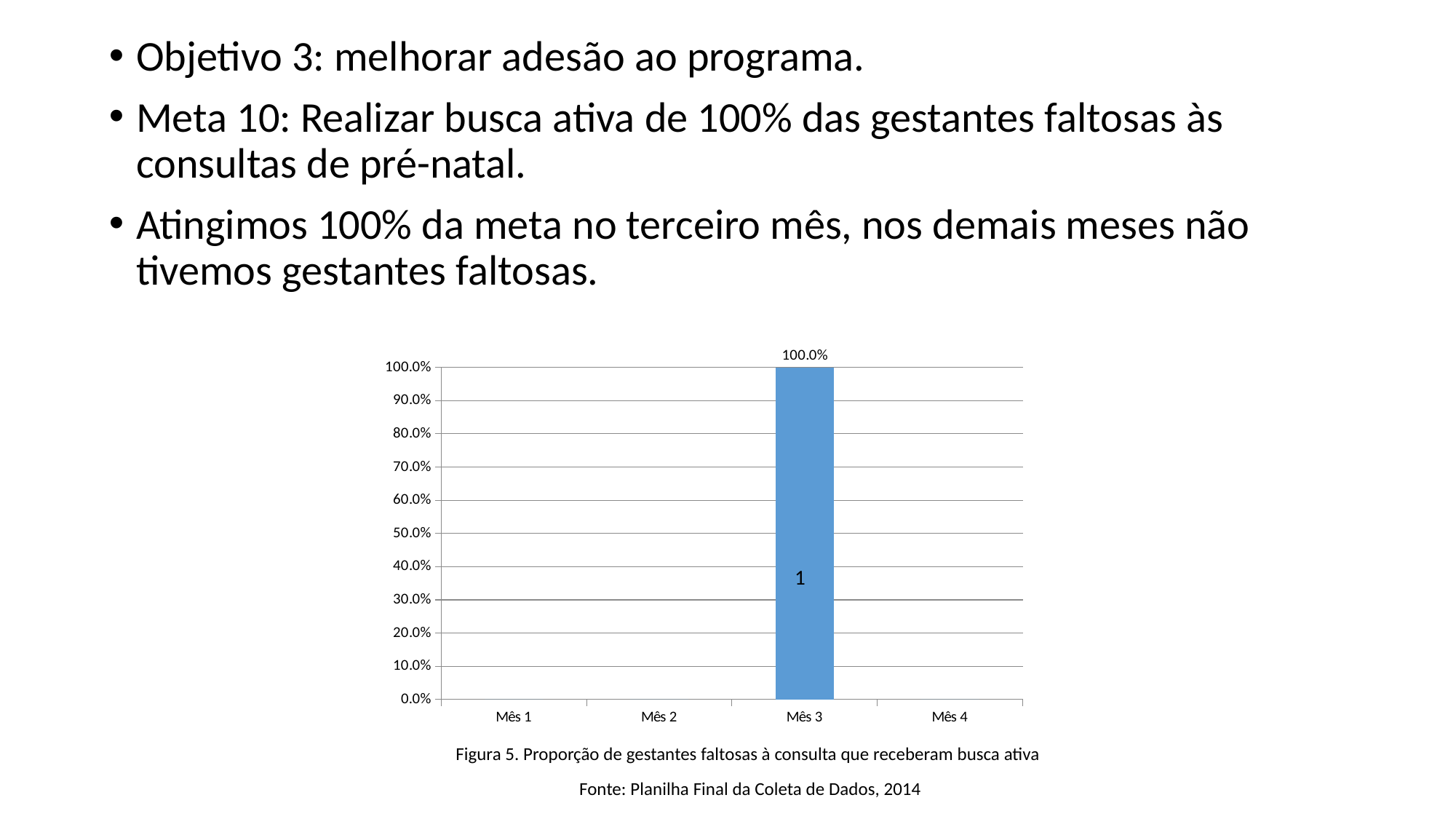
Is the value for Mês 3 greater or less than 50.0%? greater How many months are shown on the x axis of the chart? 4 Which month has the highest value in the chart? Mês 3 Which is larger, the value for Mês 3 or the value for Mês 1? Mês 3 What kind of chart is shown on the slide? Bar chart What is the value shown for Mês 3? 100.0% What is the highest tick value on the y axis of the chart? 100.0% How many months have a visible bar in the chart? 1 What is the figure caption given below the chart? Figura 5. Proporção de gestantes faltosas à consulta que receberam busca ativa